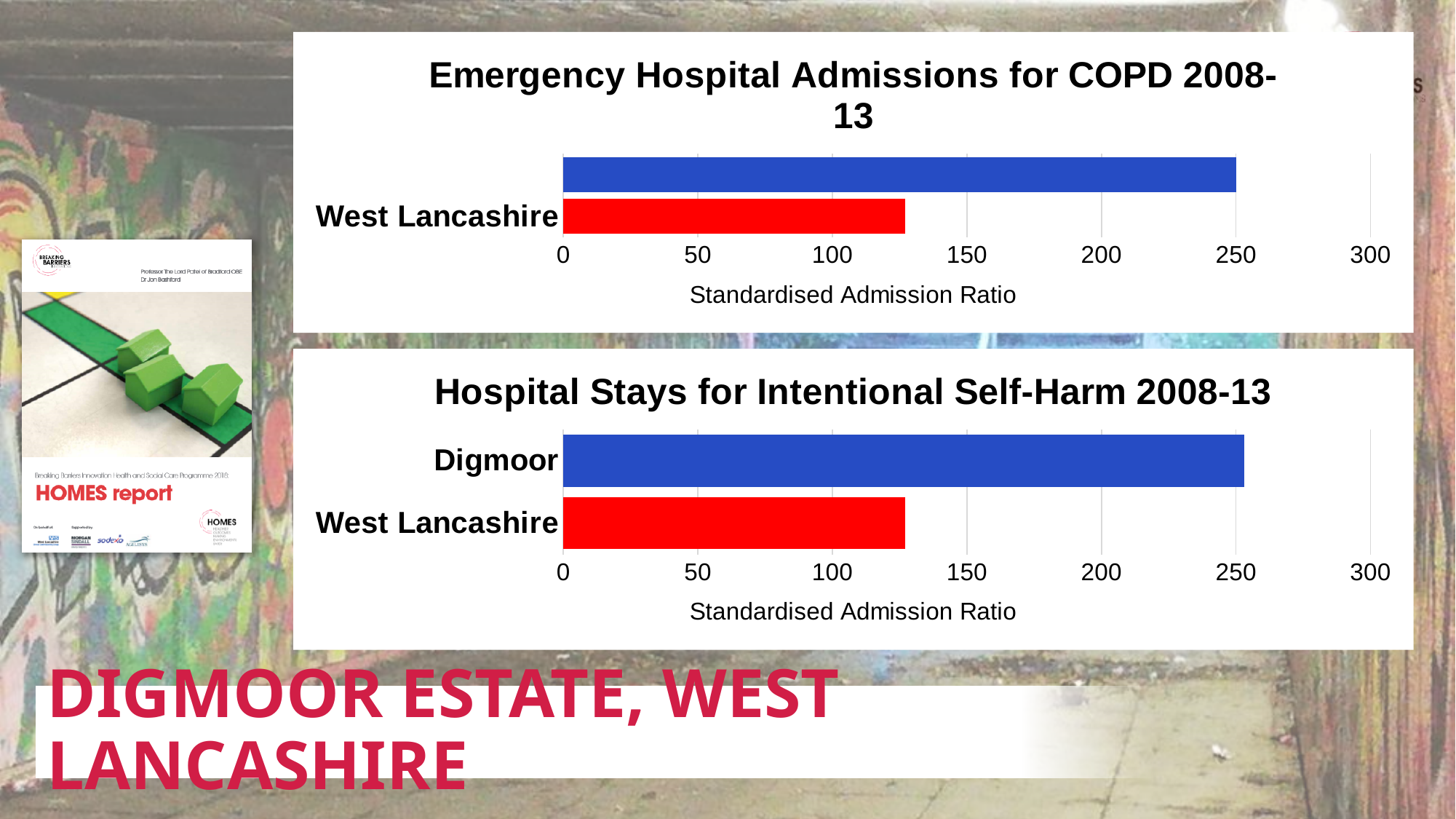
In the 'Emergency Hospital Admissions for COPD 2008-13' chart, is the value of the blue bar greater or less than 200? greater In the 'Emergency Hospital Admissions for COPD 2008-13' chart, is the value for West Lancashire greater or less than 150? less In the 'Hospital Stays for Intentional Self-Harm 2008-13' chart, which category has the highest value? Digmoor What kind of chart is the 'Hospital Stays for Intentional Self-Harm 2008-13' chart? bar chart In the 'Hospital Stays for Intentional Self-Harm 2008-13' chart, is the value for West Lancashire greater or less than 100? greater What is the x-axis title of the 'Emergency Hospital Admissions for COPD 2008-13' chart? Standardised Admission Ratio In the 'Hospital Stays for Intentional Self-Harm 2008-13' chart, what colour is the Digmoor bar? blue In the 'Hospital Stays for Intentional Self-Harm 2008-13' chart, which is larger, Digmoor or West Lancashire? Digmoor How many bars are plotted in the 'Hospital Stays for Intentional Self-Harm 2008-13' chart? 2 In the 'Hospital Stays for Intentional Self-Harm 2008-13' chart, which category has the lowest value? West Lancashire